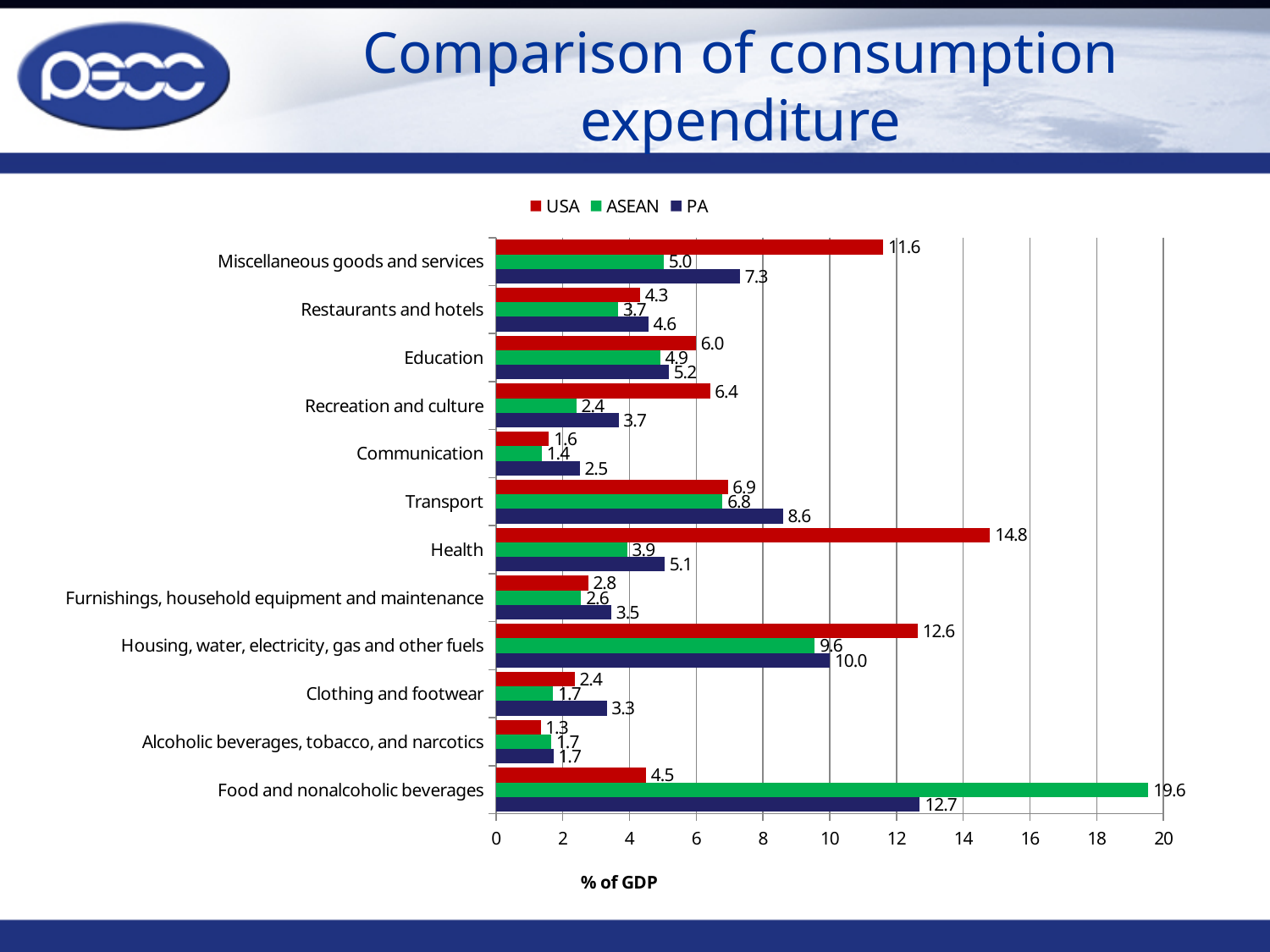
What is the USA value for Health? 14.8 For Housing, water, electricity, gas and other fuels, which is larger: the USA value or the PA value? USA How many series does the legend list? 3 What is the label of the horizontal axis? % of GDP Is the USA value for Miscellaneous goods and services greater or less than 10? greater Which category has the highest USA value? Health What is the PA value for Transport? 8.6 What is the ASEAN value for Food and nonalcoholic beverages? 19.6 What kind of chart is shown on the slide? Bar chart Which category has the lowest PA value? Alcoholic beverages, tobacco, and narcotics How many categories are shown on the chart? 12 What is the difference between the ASEAN and USA values for Food and nonalcoholic beverages? 15.1